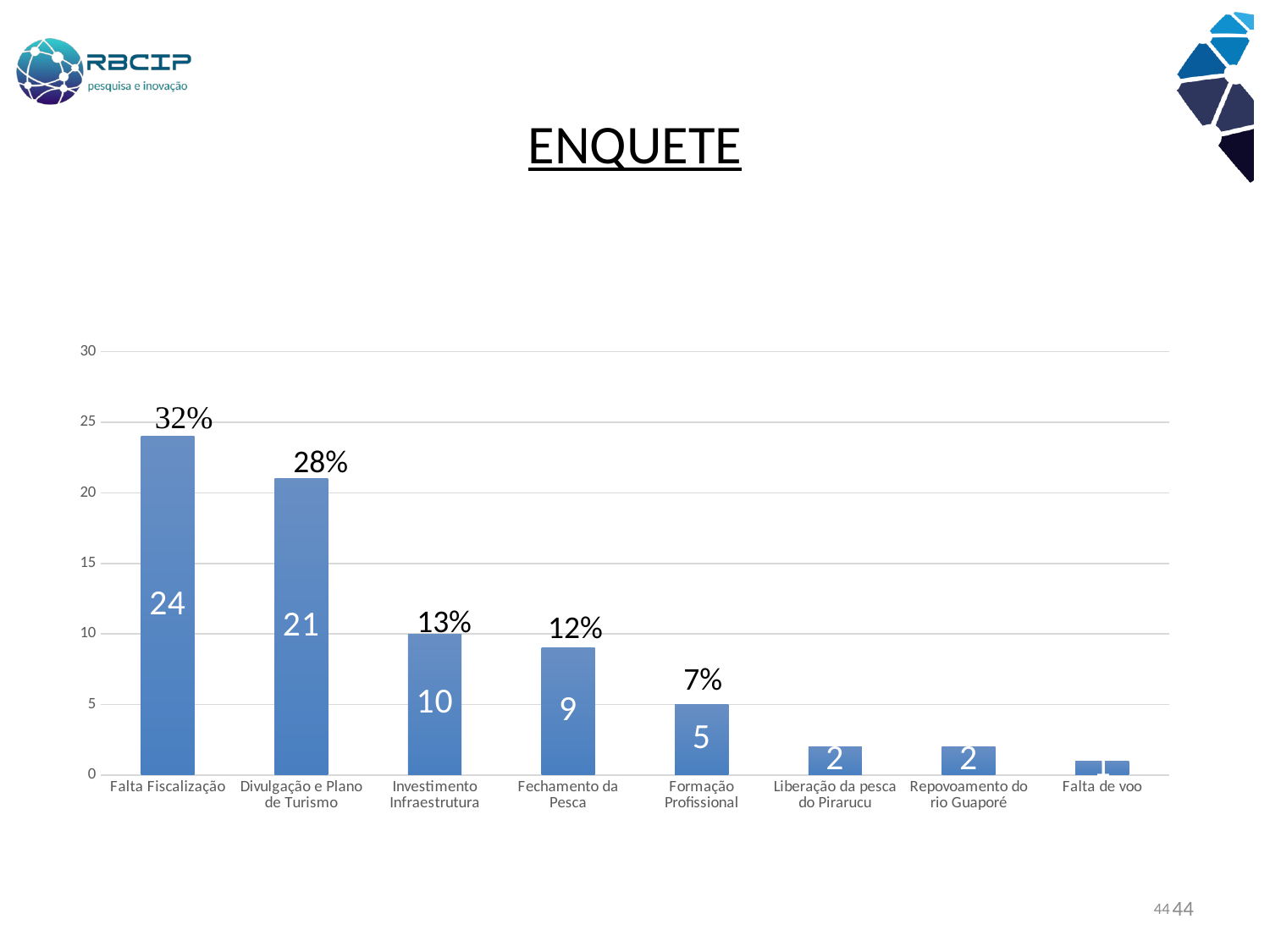
What percentage is shown above the bar for Falta Fiscalização? 32% Is the value for Falta de voo greater or less than 5? less What is the value for Formação Profissional? 5 What kind of chart is shown on the slide? bar chart What is the title of the slide containing the chart? ENQUETE What is the difference between the values for Falta Fiscalização and Divulgação e Plano de Turismo? 3 What is the value for Investimento Infraestrutura? 10 What is the value for Divulgação e Plano de Turismo? 21 What percentage is shown above the bar for Fechamento da Pesca? 12% Which category has the highest value? Falta Fiscalização Which is larger, the value for Investimento Infraestrutura or the value for Fechamento da Pesca? Investimento Infraestrutura What is the value for Falta Fiscalização? 24